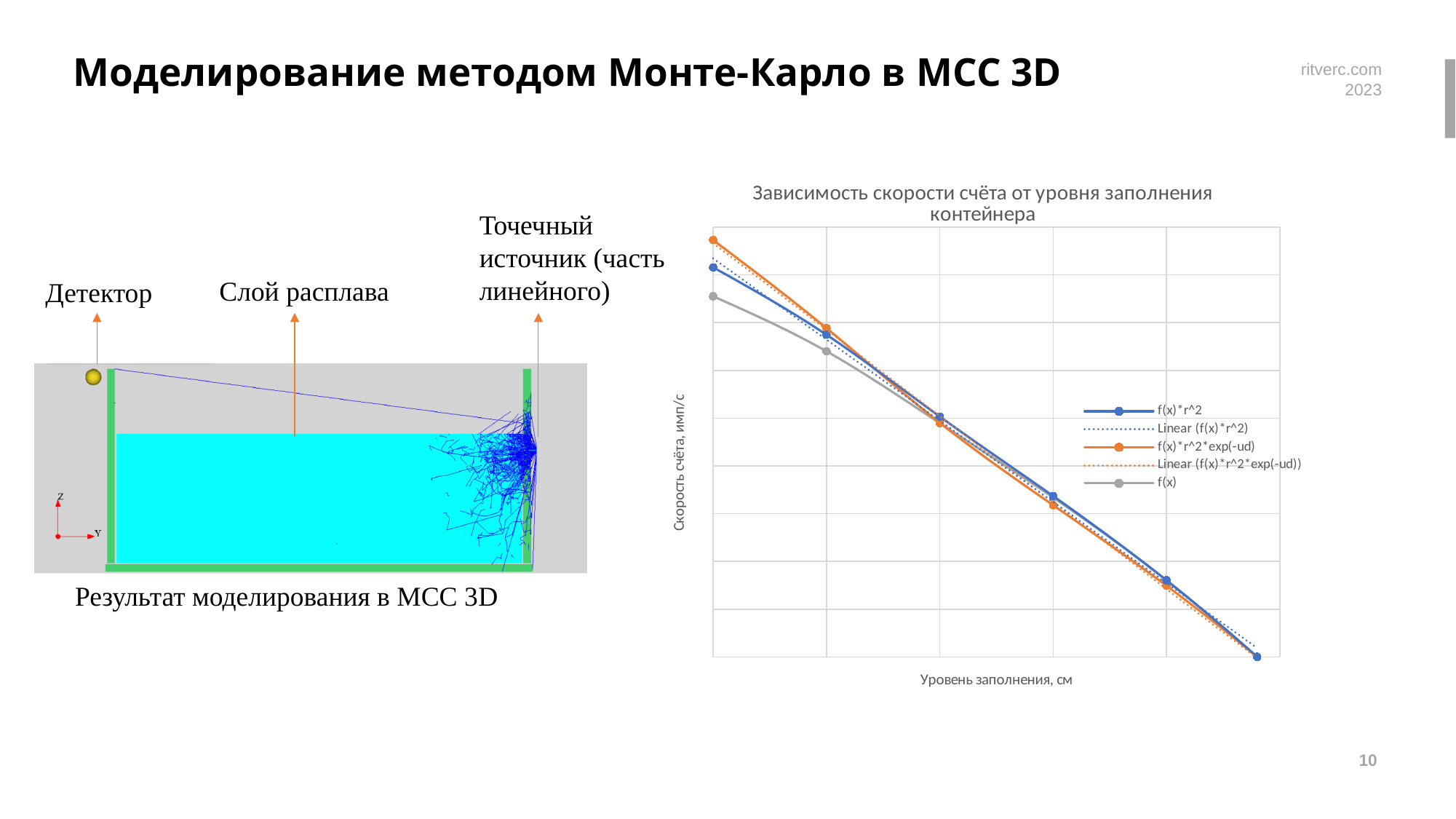
How many entries does the chart legend list? 5 Do the values of the f(x)*r^2 series rise or fall as the fill level increases along the x axis? fall Do the values of the f(x)*r^2*exp(-ud) series rise or fall along the x axis? fall Which series has the highest value at the leftmost point of the chart? f(x)*r^2*exp(-ud) What is the title of the chart? Зависимость скорости счёта от уровня заполнения контейнера At the leftmost point of the chart, which series has the higher value: f(x)*r^2 or f(x)*r^2*exp(-ud)? f(x)*r^2*exp(-ud) At the leftmost point of the chart, which series has the lower value: f(x)*r^2 or f(x)? f(x) How many data points are plotted for the f(x)*r^2 series? 6 What kind of chart is shown on the slide? line chart What is the label of the x axis of the chart? Уровень заполнения, см Which series has the lowest value at the leftmost point of the chart? f(x)